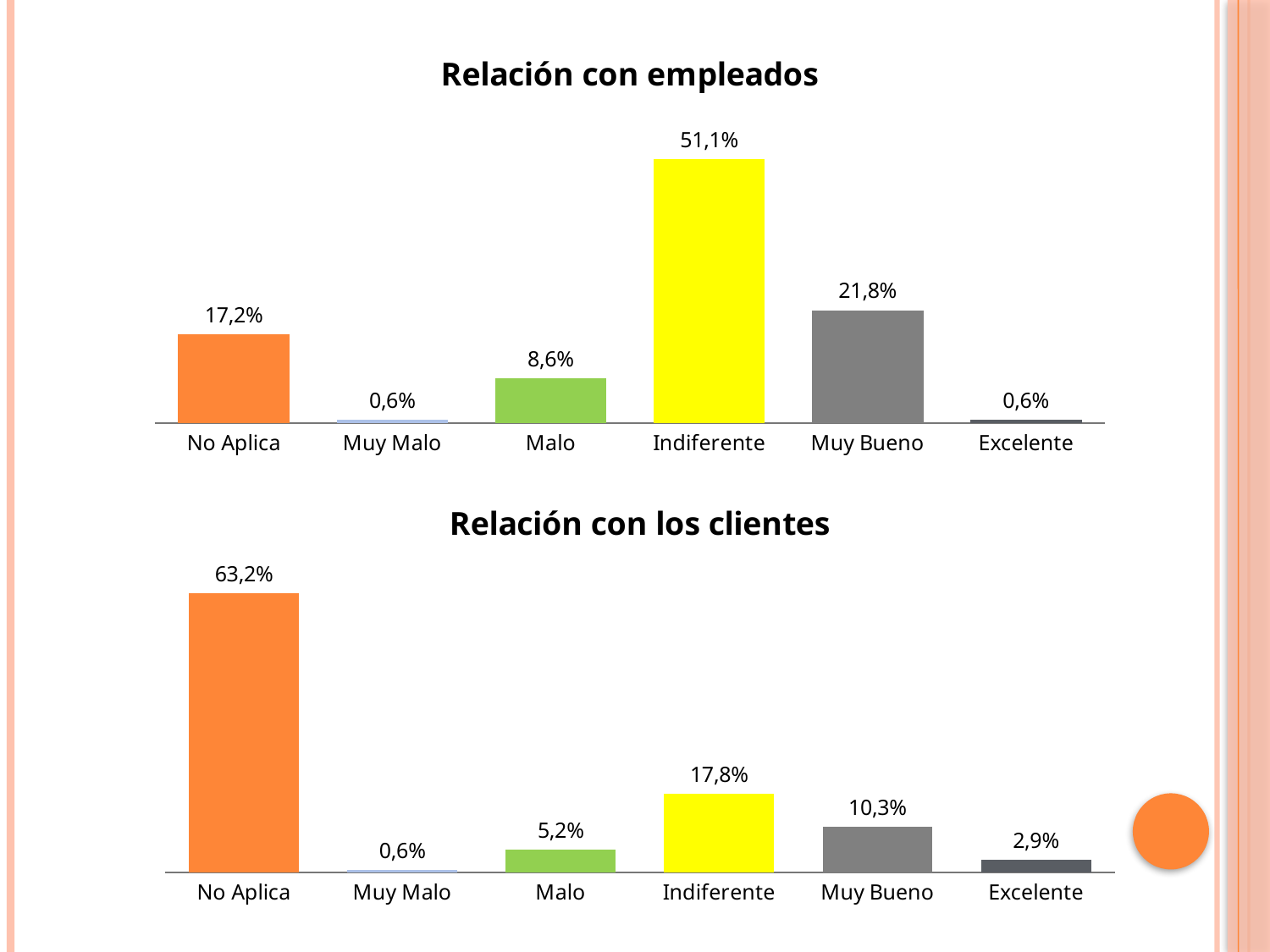
In the 'Relación con empleados' chart, which category has the highest value? Indiferente In the 'Relación con los clientes' chart, what is the difference between Indiferente and Muy Bueno? 7,5% In the 'Relación con los clientes' chart, which category has the lowest value? Muy Malo In the 'Relación con empleados' chart, what is the difference between Muy Bueno and Malo? 13,2% What kind of chart is 'Relación con los clientes'? Bar chart In the 'Relación con empleados' chart, which is larger, No Aplica or Muy Bueno? Muy Bueno In the 'Relación con empleados' chart, what is the value for Indiferente? 51,1% In the 'Relación con los clientes' chart, which is larger, Malo or Excelente? Malo In the 'Relación con los clientes' chart, what is the value for No Aplica? 63,2% In the 'Relación con los clientes' chart, what is the value for Excelente? 2,9% How many categories are shown in the 'Relación con empleados' chart? 6 What is the title of the top chart on the slide? Relación con empleados